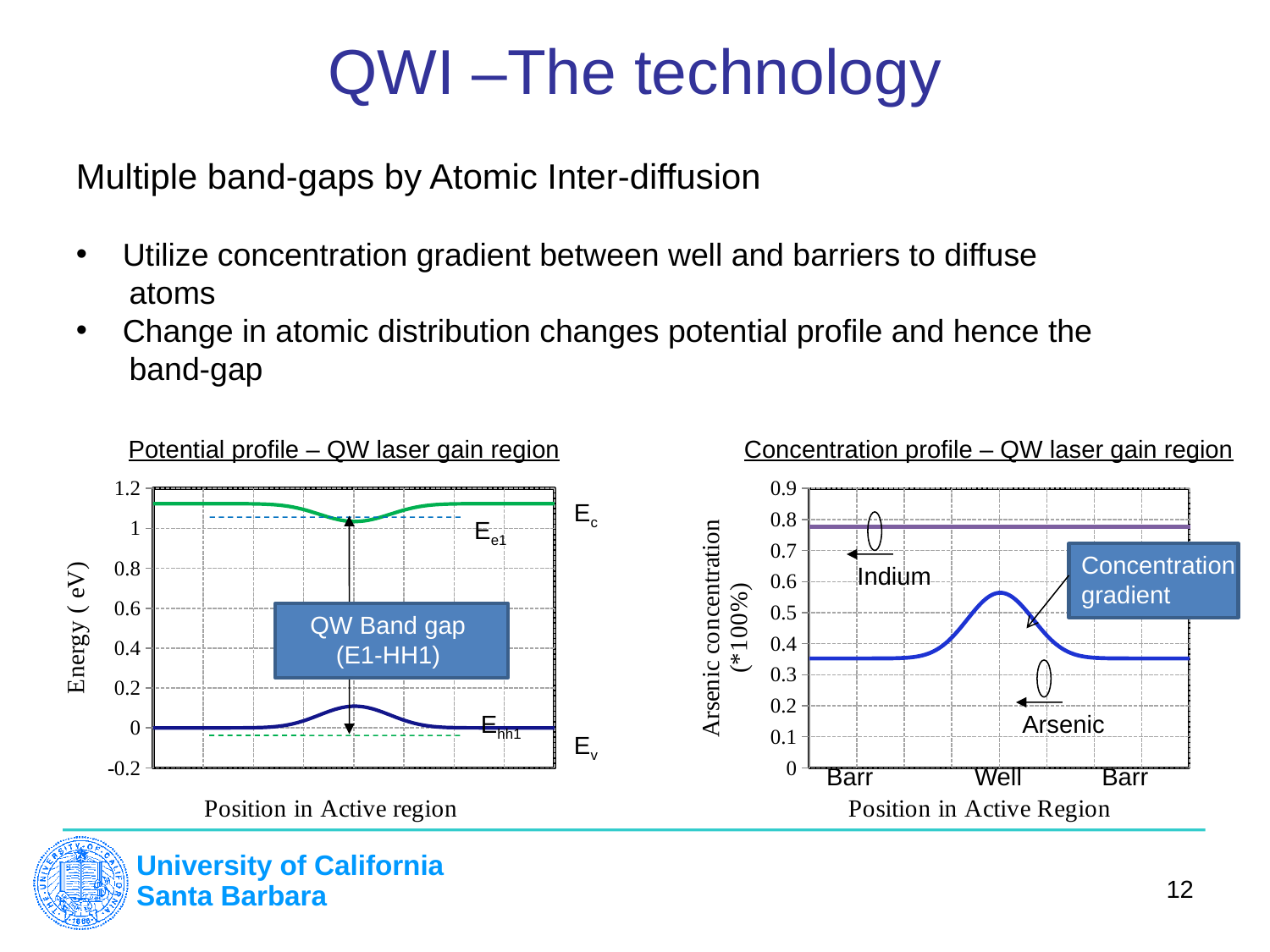
In the 'Concentration profile – QW laser gain region' chart, which line is higher, Indium or Arsenic? Indium In the 'Concentration profile – QW laser gain region' chart, what is the y-axis title? Arsenic concentration (*100%) In the 'Concentration profile – QW laser gain region' chart, is the Arsenic concentration at its peak in the Well region greater or less than 0.5? greater What kind of chart is the 'Concentration profile – QW laser gain region' chart? line chart What kind of chart is the 'Potential profile – QW laser gain region' chart? line chart In the 'Concentration profile – QW laser gain region' chart, is the Indium concentration greater or less than 0.7? greater In the 'Concentration profile – QW laser gain region' chart, does the Arsenic concentration rise or fall when moving from the Barr region into the Well region? rise How many position labels are shown on the x-axis of the 'Concentration profile – QW laser gain region' chart? 3 In the 'Potential profile – QW laser gain region' chart, is the value of the Ec line in the barrier regions greater or less than 0.8? greater In the 'Potential profile – QW laser gain region' chart, what is the y-axis title? Energy ( eV)